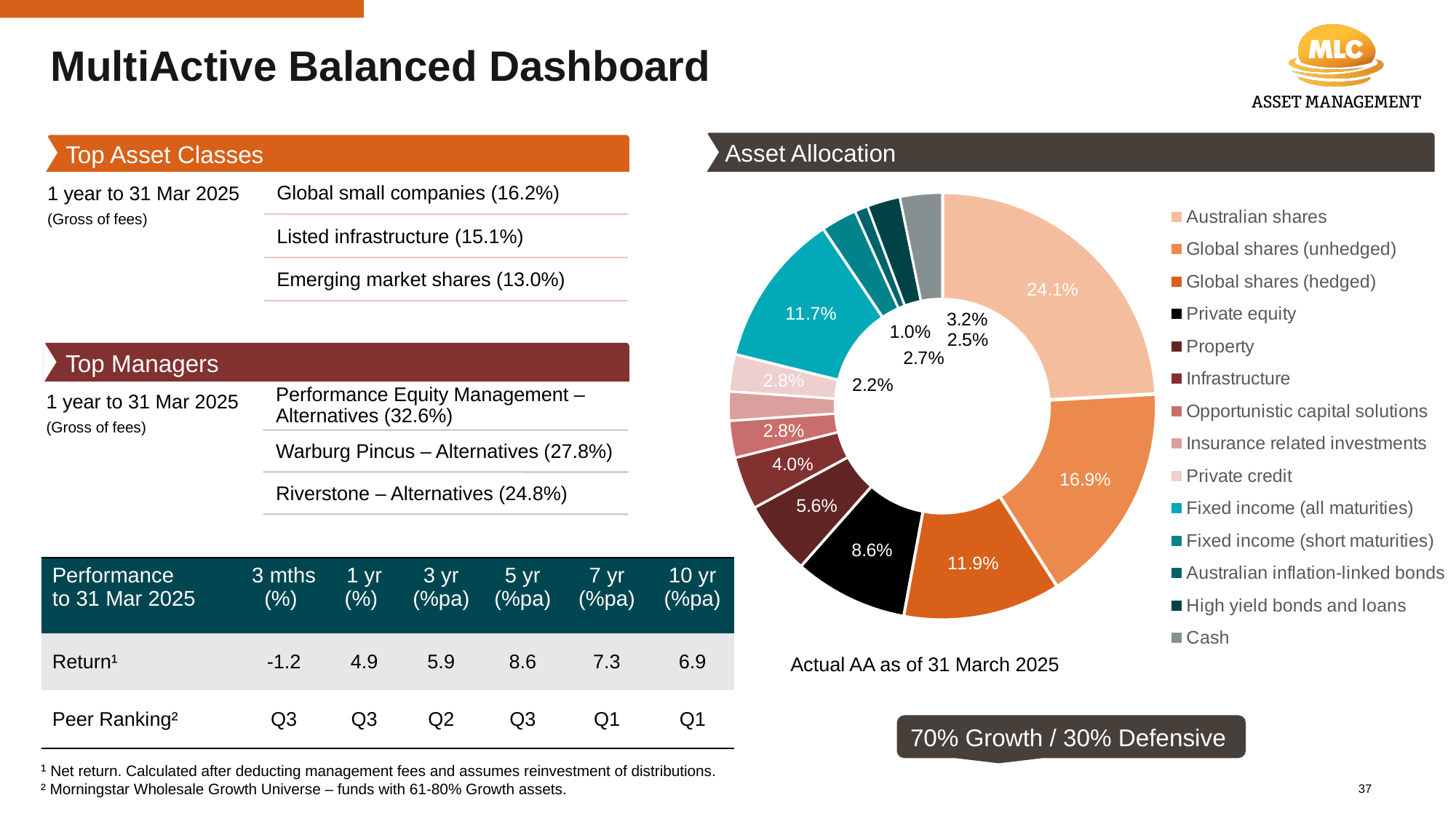
In the Asset Allocation chart, what share is allocated to Private equity? 8.6% What kind of chart is shown under Asset Allocation? Doughnut (pie) chart In the Asset Allocation chart, what share is allocated to Property? 5.6% In the Asset Allocation chart, what share is allocated to Global shares (hedged)? 11.9% In the Asset Allocation chart, what share is allocated to Global shares (unhedged)? 16.9% Which asset class has the smallest allocation in the Asset Allocation chart? Australian inflation-linked bonds In the Asset Allocation chart, what share is allocated to Fixed income (all maturities)? 11.7% In the Asset Allocation chart, which has the larger allocation: Private equity or Property? Private equity In the Asset Allocation chart, what share is allocated to Australian shares? 24.1% Which asset class has the largest allocation in the Asset Allocation chart? Australian shares In the Asset Allocation chart, how many percentage points larger is the Australian shares allocation than the Global shares (unhedged) allocation? 7.2 percentage points How many asset classes are listed in the legend of the Asset Allocation chart? 14